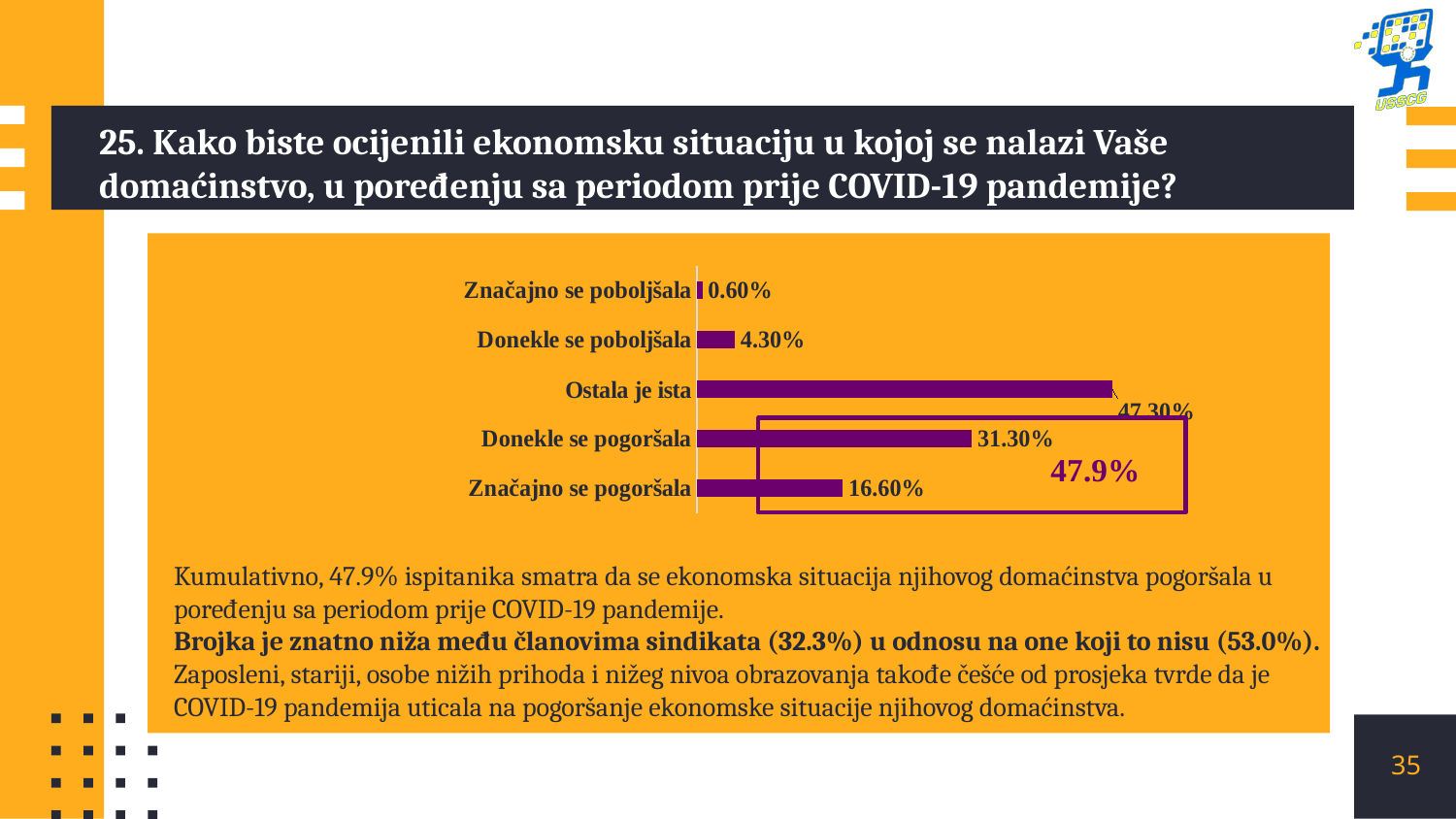
What is the value for "Značajno se poboljšala"? 0.60% What kind of chart is shown on the slide? bar chart Which category has the highest value? Ostala je ista Which category has the lowest value? Značajno se poboljšala What is the value for "Donekle se poboljšala"? 4.30% What is the value for "Donekle se pogoršala"? 31.30% What is the value for "Značajno se pogoršala"? 16.60% Which is larger, the value for "Donekle se poboljšala" or the value for "Značajno se pogoršala"? Značajno se pogoršala What cumulative percentage is highlighted in the box around the two "pogoršala" bars? 47.9% How many categories does the chart show? 5 What is the difference between the values for "Donekle se poboljšala" and "Značajno se poboljšala"? 3.70% What is the difference between the values for "Donekle se pogoršala" and "Značajno se pogoršala"? 14.70%